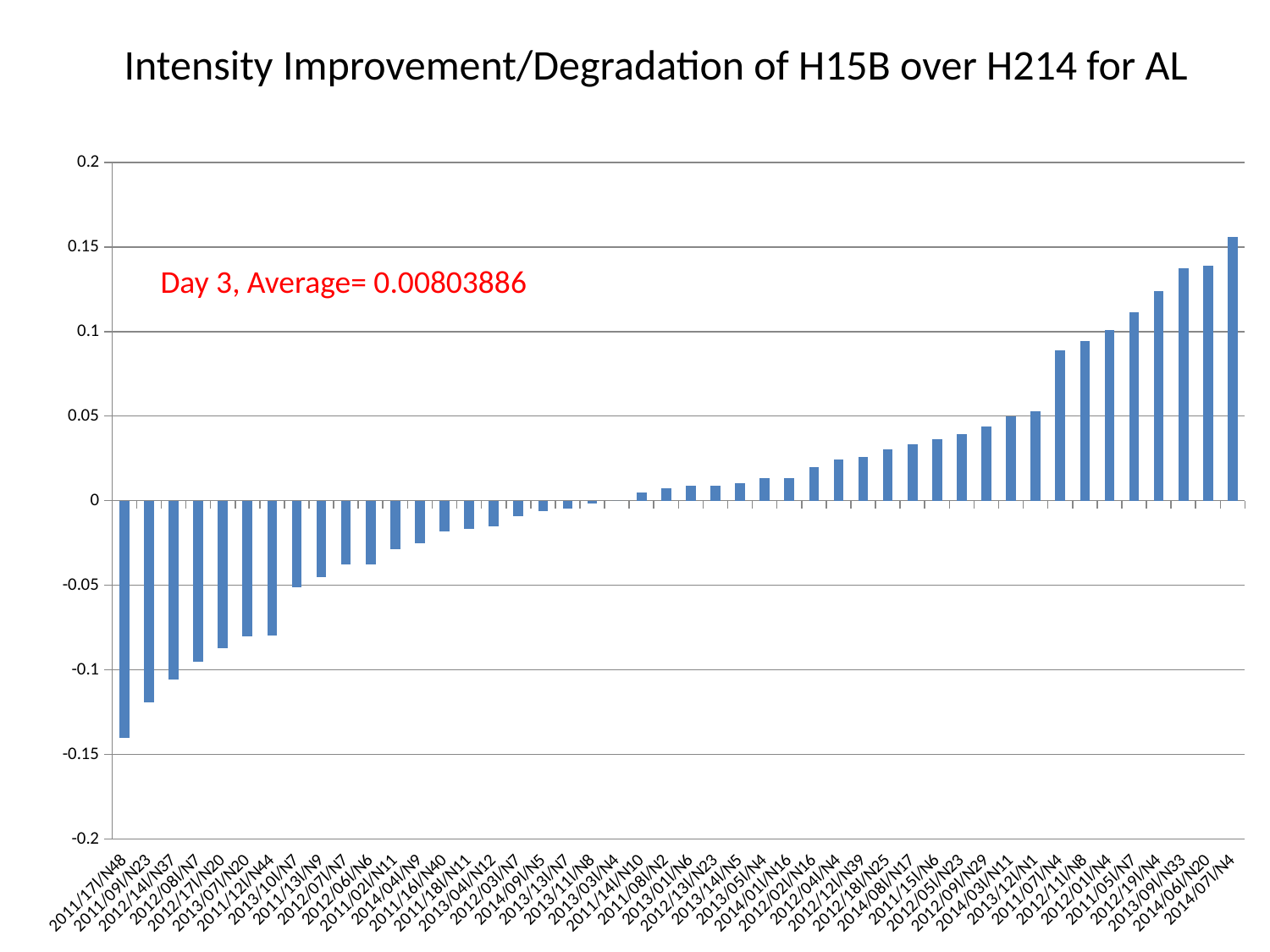
Is the value for 2011/09/N23 greater or less than -0.1? less Is the value for 2014/07/N4 greater or less than 0.1? greater What average value is stated in the red text on the chart? 0.00803886 What is the maximum value shown on the vertical axis? 0.2 Which is larger, the value for 2011/17/N48 or the value for 2014/07/N4? 2014/07l/N4 Do the bar values rise or fall moving from left to right along the x axis? rise What is the title of the chart? Intensity Improvement/Degradation of H15B over H214 for AL Which category has the lowest value? 2011/17l/N48 Which category has the highest value? 2014/07l/N4 What type of chart is shown on the slide? bar chart Is the value for 2011/17/N48 greater or less than -0.1? less